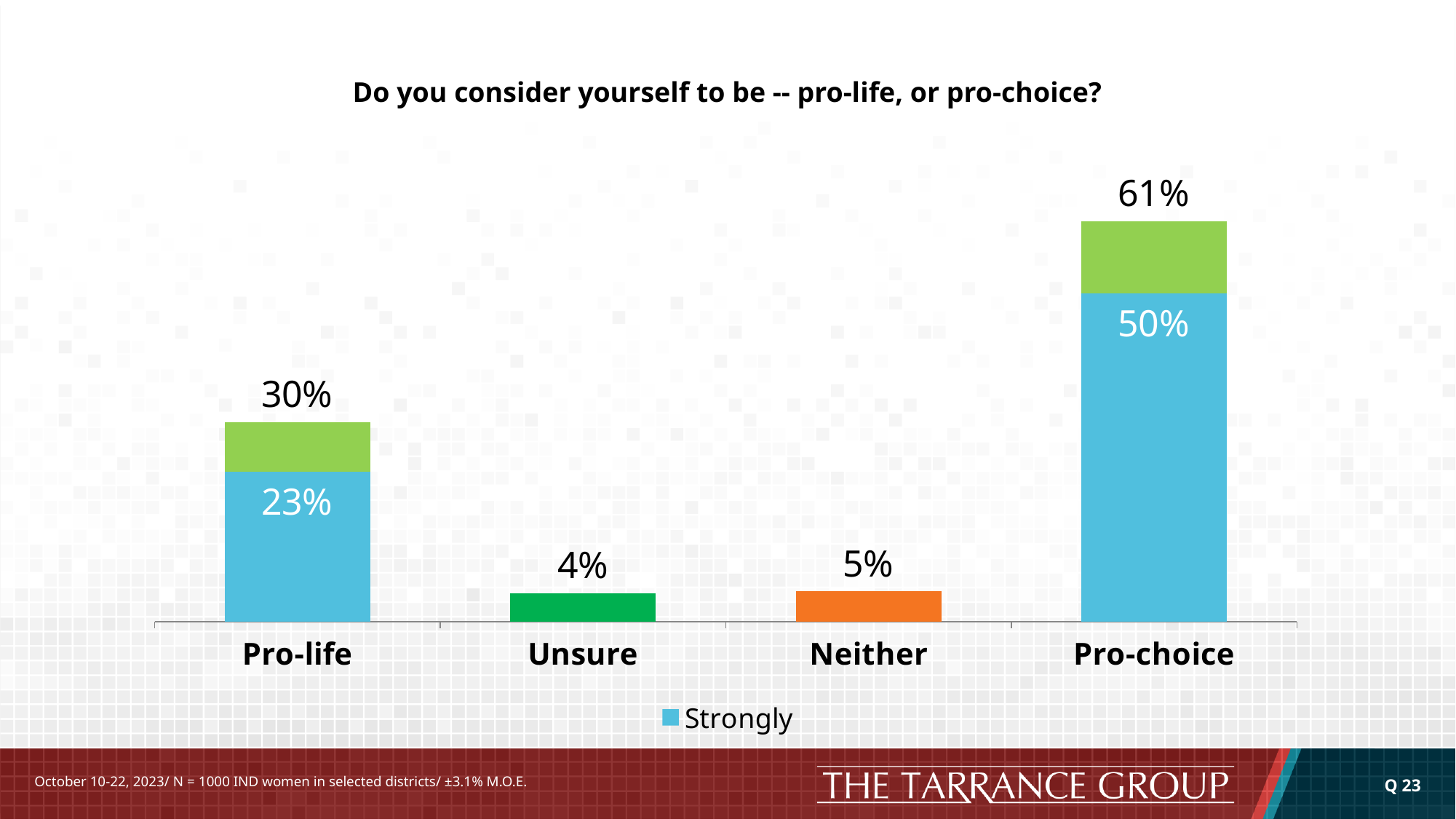
What is the 'Strongly' value for Pro-life? 23% What kind of chart is shown on the slide? Bar chart What is the value shown for Unsure? 4% What is the 'Strongly' value for Pro-choice? 50% How many series does the legend list? 1 Which category has the lowest value? Unsure Which category has the highest total value? Pro-choice What is the total value shown for Pro-life? 30% Which is larger, the value for Neither or the value for Unsure? Neither How many categories are shown on the x axis? 4 What is the total value shown for Pro-choice? 61% What is the difference between the total for Pro-choice and the total for Pro-life? 31%